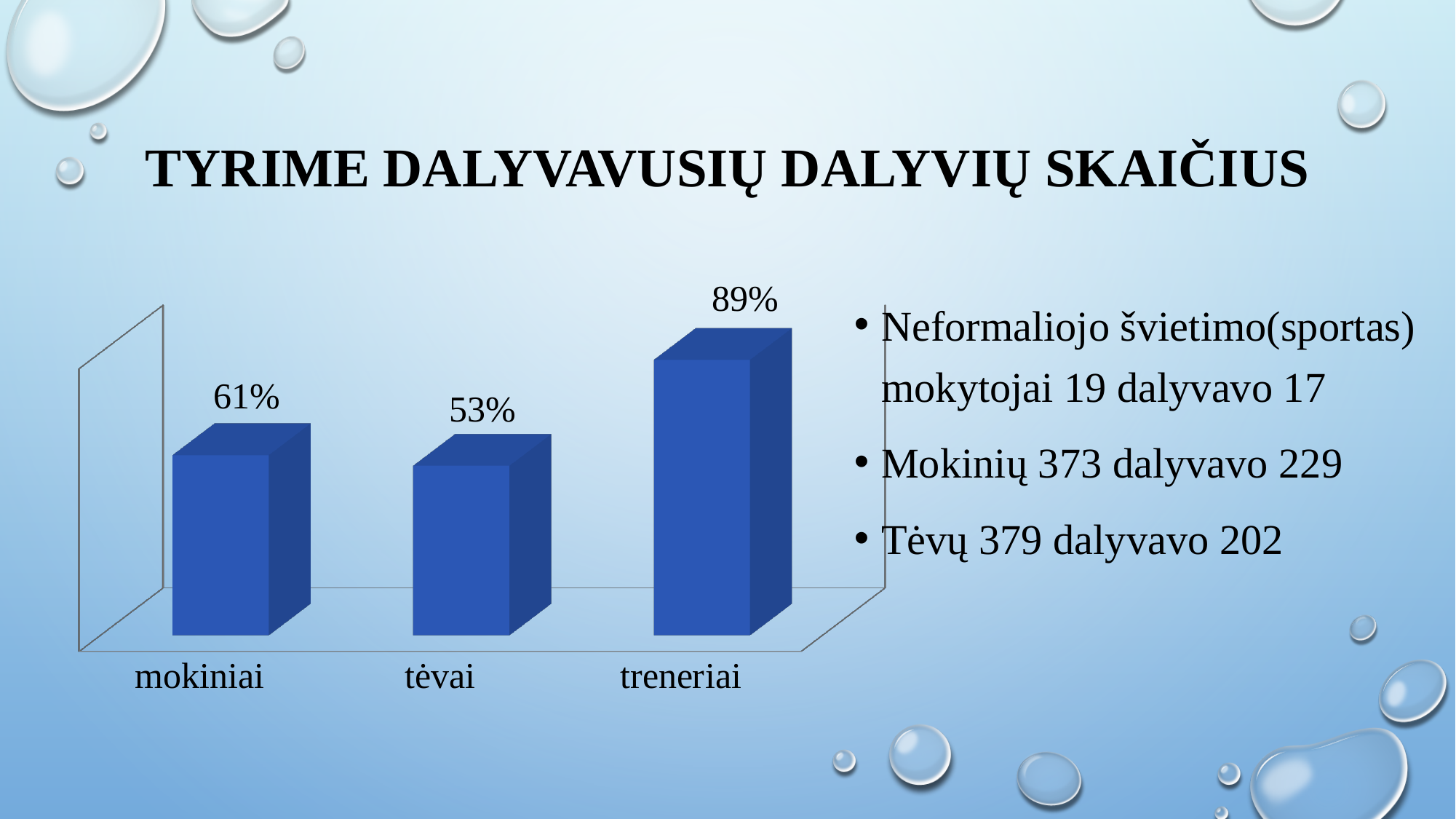
What is the value for treneriai? 89% What colour are the bars in the chart? blue What is the title of the slide containing the chart? TYRIME DALYVAVUSIŲ DALYVIŲ SKAIČIUS Which category has the lowest value? tėvai What is the difference between the values for treneriai and mokiniai? 28% How many categories are shown in the chart? 3 What is the difference between the values for mokiniai and tėvai? 8% Which category has the highest value? treneriai What kind of chart is shown on the slide? bar chart Which is larger, the value for mokiniai or the value for tėvai? mokiniai What is the value for tėvai? 53% What is the value for mokiniai? 61%